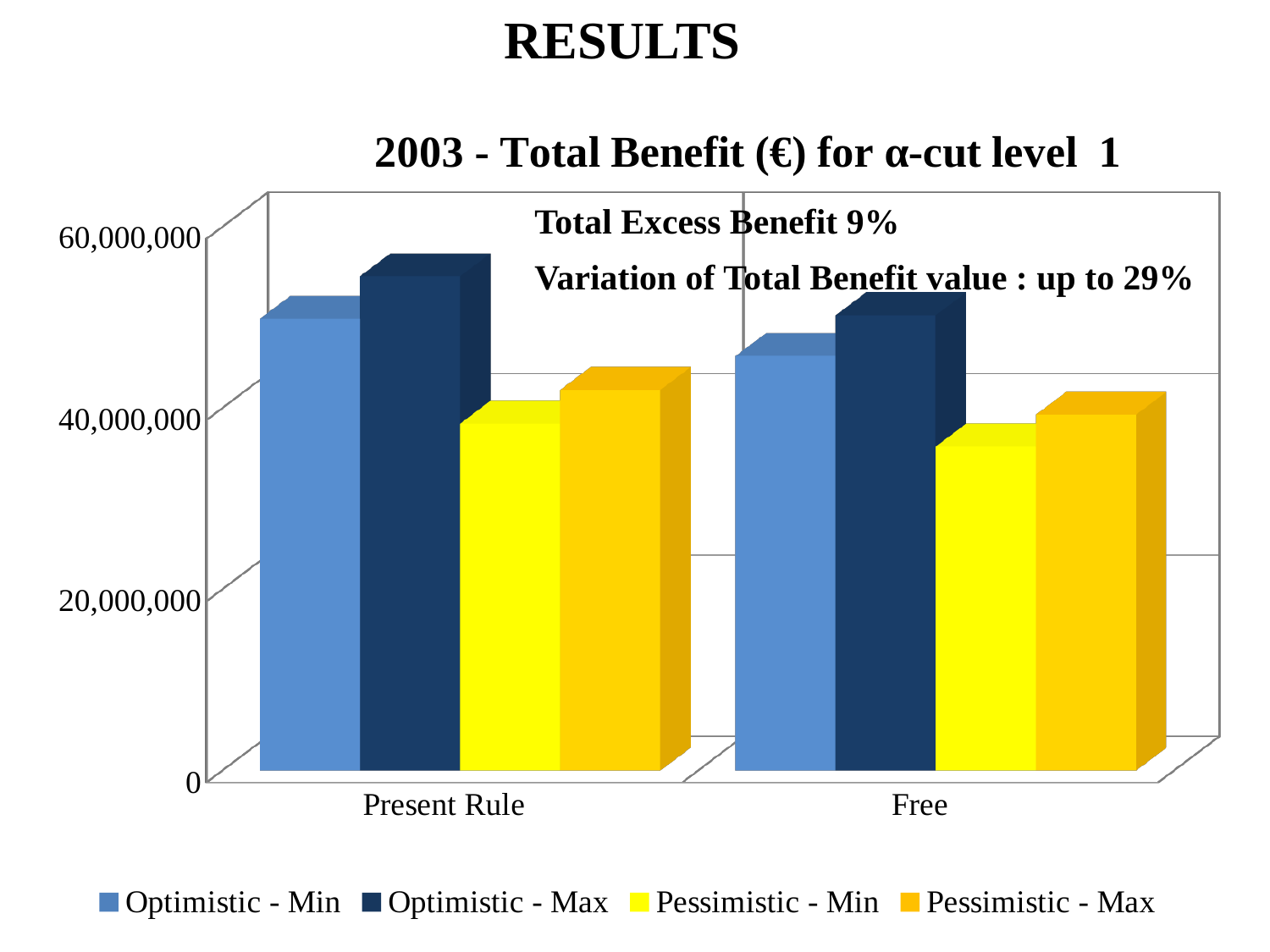
How many series does the legend list? 4 Is the value for Optimistic - Min under Free greater or less than 60,000,000? less Is the value for Optimistic - Max under Present Rule greater or less than 40,000,000? greater Which series has the highest value for Present Rule? Optimistic - Max Which is larger: Optimistic - Max for Present Rule or Optimistic - Max for Free? Present Rule Is the value for Pessimistic - Min under Free greater or less than 40,000,000? less Which series has the lowest value for Free? Pessimistic - Min How many categories are shown on the x axis? 2 What percentage is given for Total Excess Benefit in the chart annotation? 9% What is the title of the chart? 2003 - Total Benefit (€) for α-cut level 1 What kind of chart is shown on the slide? bar chart Do the Optimistic - Min values rise or fall from Present Rule to Free? fall